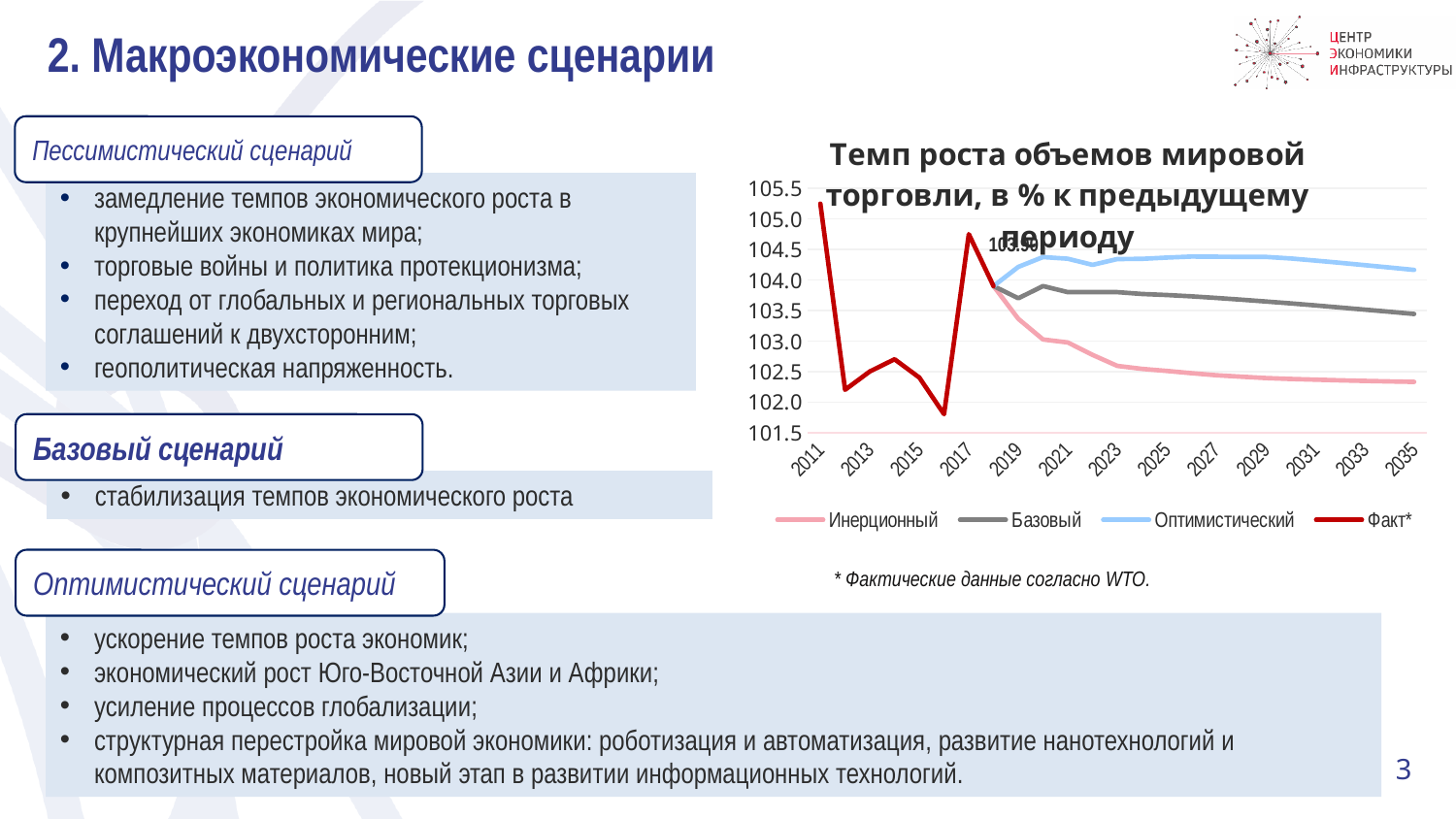
How many year labels are shown on the x axis of the chart? 13 Which series has the lowest value in 2035? Инерционный Does the Инерционный series rise or fall from 2019 to 2035? fall What kind of chart is shown on the slide? Line chart Is the value of the Базовый series in 2035 greater or less than 103.0? greater Which series has the highest value in 2035? Оптимистический Is the value of the Факт* series in 2011 greater or less than 105.0? greater Which series in the chart legend is marked with an asterisk? Факт* Is the value of the Оптимистический series in 2035 greater or less than 104.0? greater How many series does the chart legend list? 4 What is the title of the chart? Темп роста объемов мировой торговли, в % к предыдущему периоду